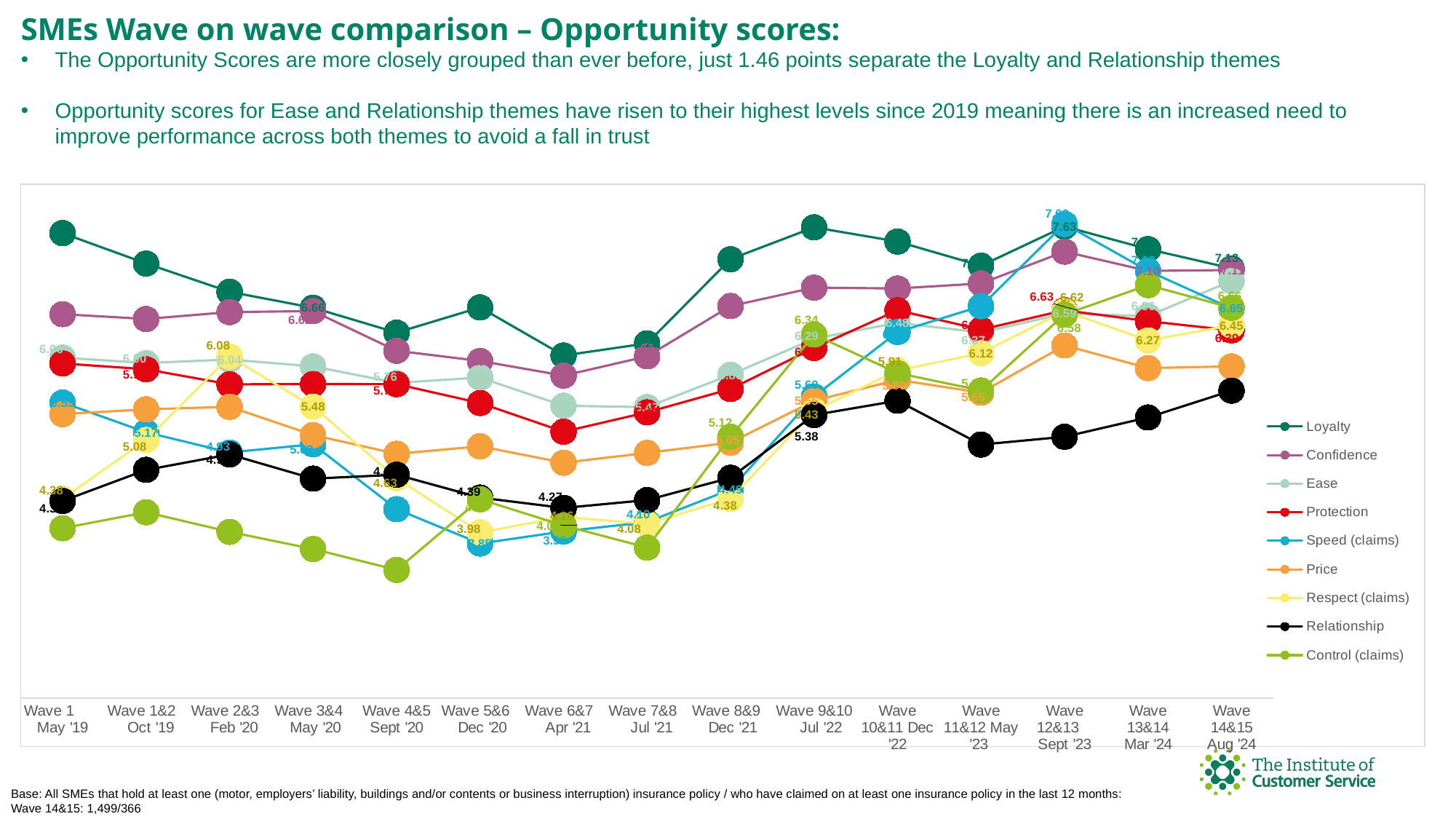
Which theme has the lowest opportunity score at Wave 14&15 Aug '24? Relationship Which theme has the lowest opportunity score at Wave 4&5 Sept '20? Control (claims) How many series does the legend list? 9 What is the Respect (claims) opportunity score at Wave 1&2 Oct '19? 5.08 What is the Relationship opportunity score at Wave 9&10 Jul '22? 5.38 What is the Speed (claims) opportunity score at Wave 12&13 Sept '23? 7.66 Which theme has the highest opportunity score at Wave 1 May '19? Loyalty What is the title of the slide? SMEs Wave on wave comparison – Opportunity scores: What is the difference between the Respect (claims) scores at Wave 3&4 May '20 (5.48) and Wave 1&2 Oct '19 (5.08)? 0.40 What kind of chart is shown on the slide? line chart Does the Loyalty opportunity score rise or fall from Wave 1 May '19 to Wave 6&7 Apr '21? fall How many waves are shown along the x axis? 15